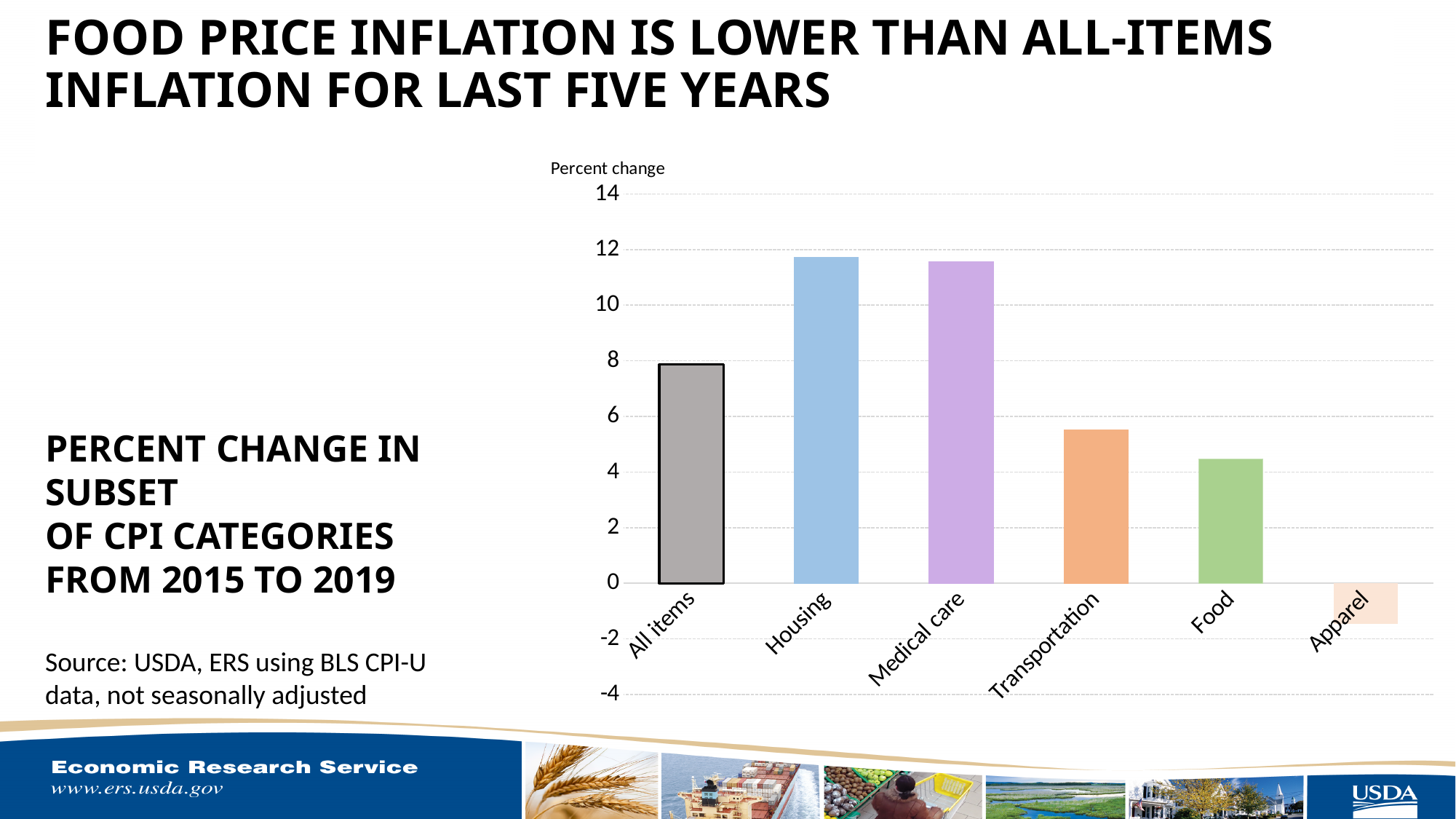
What is the label shown above the vertical axis of the chart? Percent change Which has the larger percent change, All items or Food? All items Is the value for Medical care greater or less than 10? greater What kind of chart is shown on the slide? Bar chart Is the value for Housing greater or less than 10? greater Is the value for Transportation greater or less than 6? less How many CPI categories are plotted in the chart? 6 Which has the larger percent change, Transportation or Food? Transportation Which category has the lowest percent change in the chart? Apparel